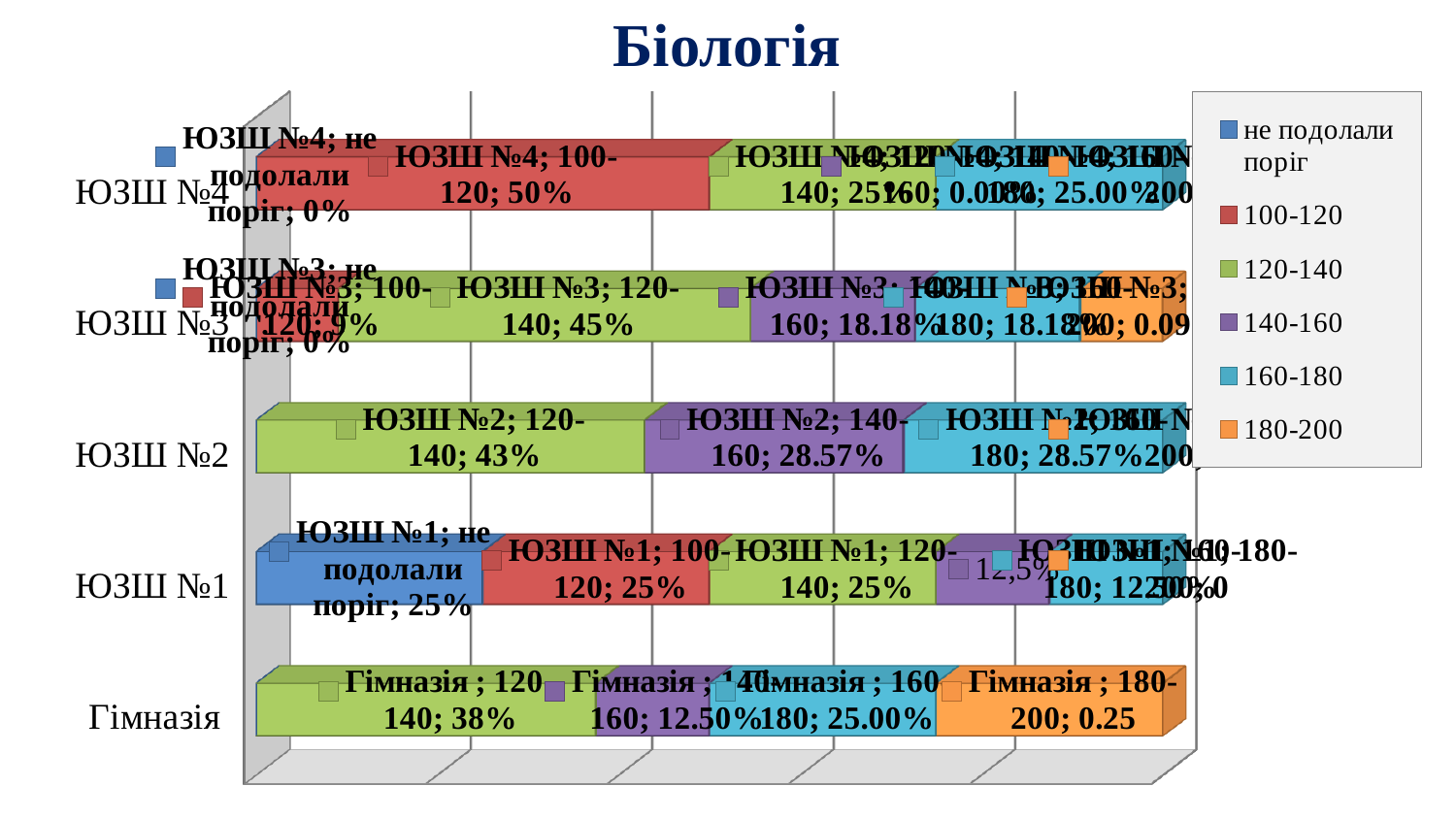
What is the value of the 140-160 segment for ЮЗШ №2? 28.57% What is the value of the 100-120 segment for ЮЗШ №4? 50% What is the title of the chart? Біологія Which is larger: the 100-120 segment for ЮЗШ №4 or the 100-120 segment for ЮЗШ №1? ЮЗШ №4 What is the difference between the 100-120 segment for ЮЗШ №4 (50%) and the 100-120 segment for ЮЗШ №1 (25%)? 25% How many schools (categories) are plotted on the chart? 5 What is the value of the 'не подолали поріг' segment for ЮЗШ №1? 25% What kind of chart is shown on the slide? Stacked bar chart Which school has the largest 120-140 segment? ЮЗШ №3 What is the value of the 180-200 segment for Гімназія? 0.25 How many series does the legend list? 6 What is the value of the 120-140 segment for ЮЗШ №3? 45%